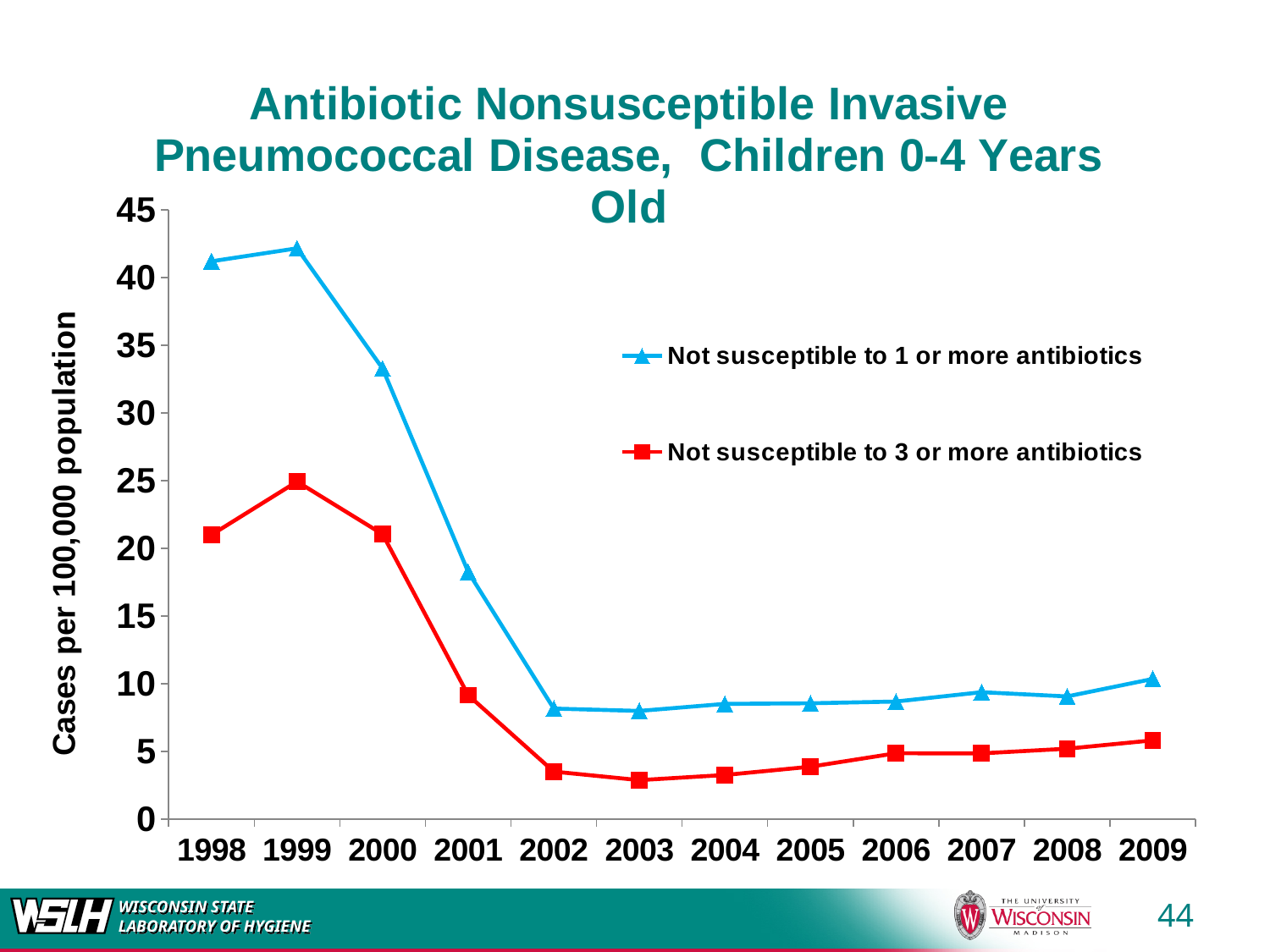
How many series does the legend list? 2 What is the label of the y axis? Cases per 100,000 population Which series has the larger value in 2001, 'Not susceptible to 1 or more antibiotics' or 'Not susceptible to 3 or more antibiotics'? Not susceptible to 1 or more antibiotics Is the value for 'Not susceptible to 1 or more antibiotics' in 1998 greater or less than 40? greater Is the value for 'Not susceptible to 3 or more antibiotics' in 2002 greater or less than 5? less Is the value for 'Not susceptible to 3 or more antibiotics' in 1999 greater or less than 30? less In which year is the value for 'Not susceptible to 3 or more antibiotics' highest? 1999 How many years are plotted along the x axis? 12 What kind of chart is shown on the slide? line chart In which year is the value for 'Not susceptible to 1 or more antibiotics' highest? 1999 Do the values for 'Not susceptible to 1 or more antibiotics' rise or fall from 1999 to 2002? fall